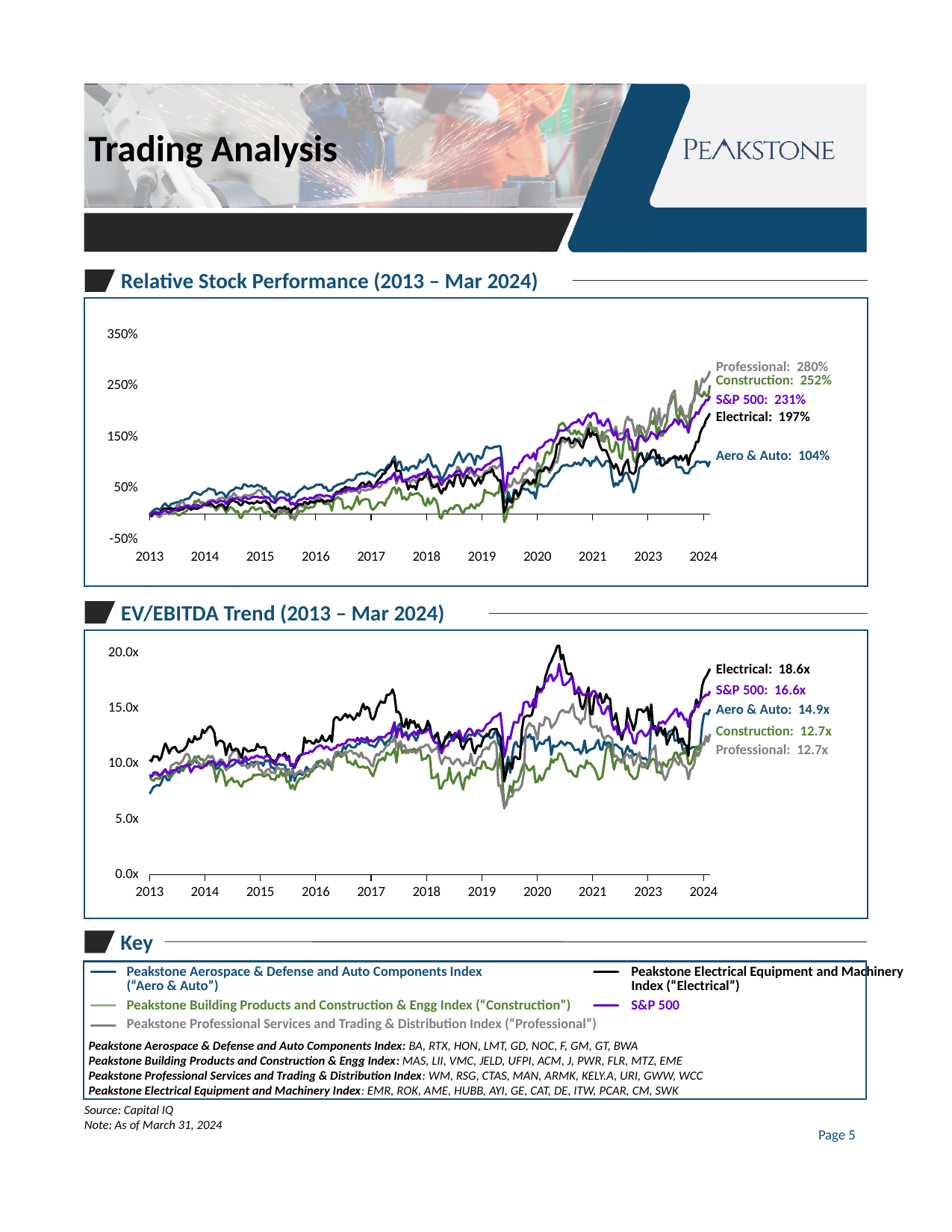
In the Relative Stock Performance chart, what is the end value shown for Aero & Auto? 104% In the EV/EBITDA Trend chart, what is the end value shown for S&P 500? 16.6x What type of chart is the EV/EBITDA Trend chart? Line chart In the Relative Stock Performance chart, which index has the highest end value? Professional In the EV/EBITDA Trend chart, which index has the highest end value? Electrical How many series does the Key list for the charts? 5 In the EV/EBITDA Trend chart, what is the end value shown for Electrical? 18.6x In the Relative Stock Performance chart, what is the end value shown for Professional? 280% In the Relative Stock Performance chart, which has the larger end value, Electrical or S&P 500? S&P 500 In the Relative Stock Performance chart, which index has the lowest end value? Aero & Auto In the Relative Stock Performance chart, what is the difference between the end values for Construction and S&P 500? 21% In the EV/EBITDA Trend chart, what is the difference between the end values for Electrical and Aero & Auto? 3.7x